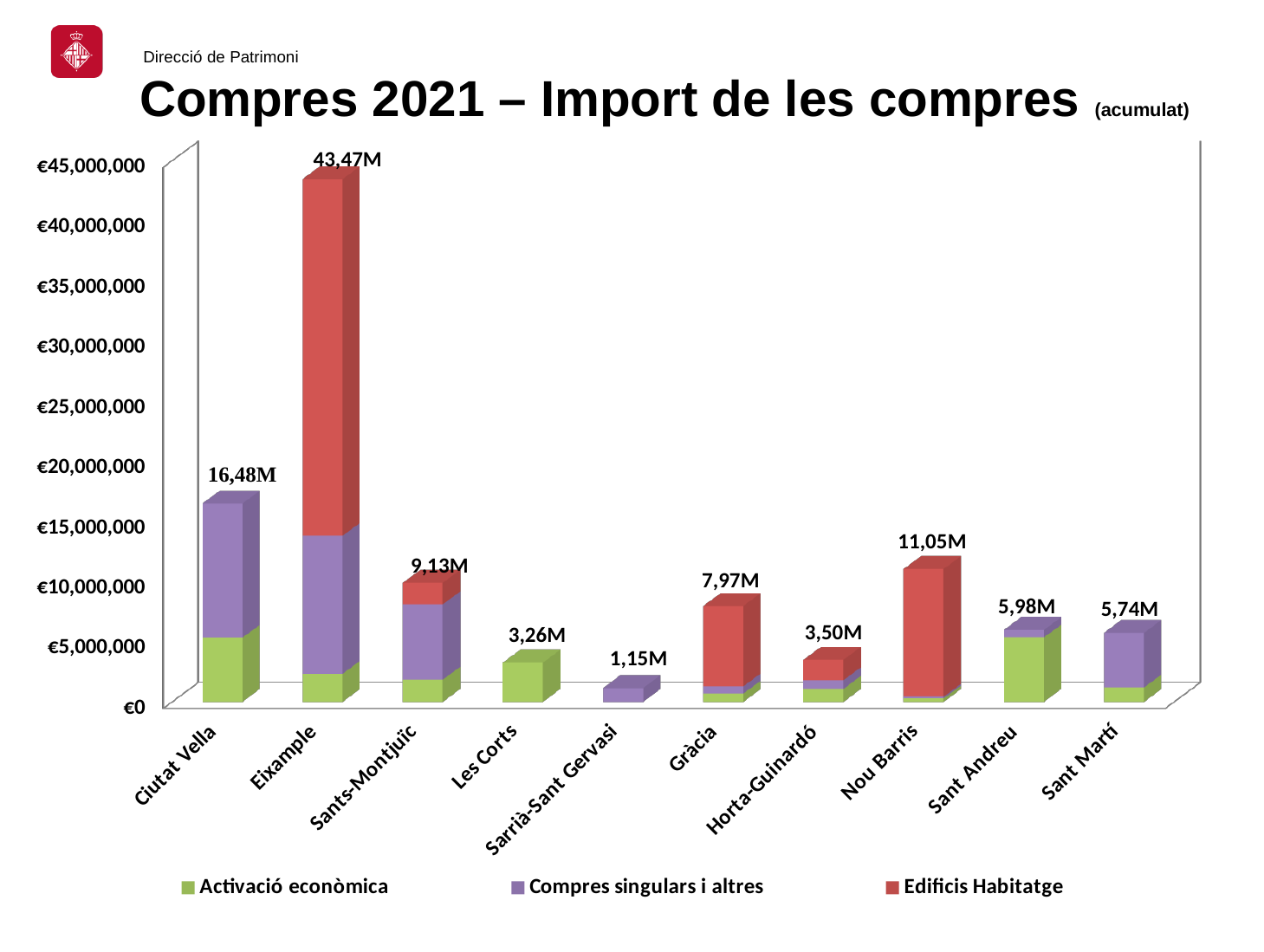
What is the total labelled for Ciutat Vella? 16,48M How many series does the legend list? 3 Which district has the lowest total? Sarrià-Sant Gervasi What is the difference between the totals for Eixample and Ciutat Vella? 26,99M Is the total for Ciutat Vella greater or less than €15,000,000? greater What is the total labelled for Nou Barris? 11,05M How many districts are shown on the x axis? 10 What kind of chart is shown on the slide? Stacked bar chart What is the total labelled for Sarrià-Sant Gervasi? 1,15M What is the total labelled for Eixample? 43,47M Which has a larger total, Sant Andreu or Sant Martí? Sant Andreu Which district has the highest total? Eixample